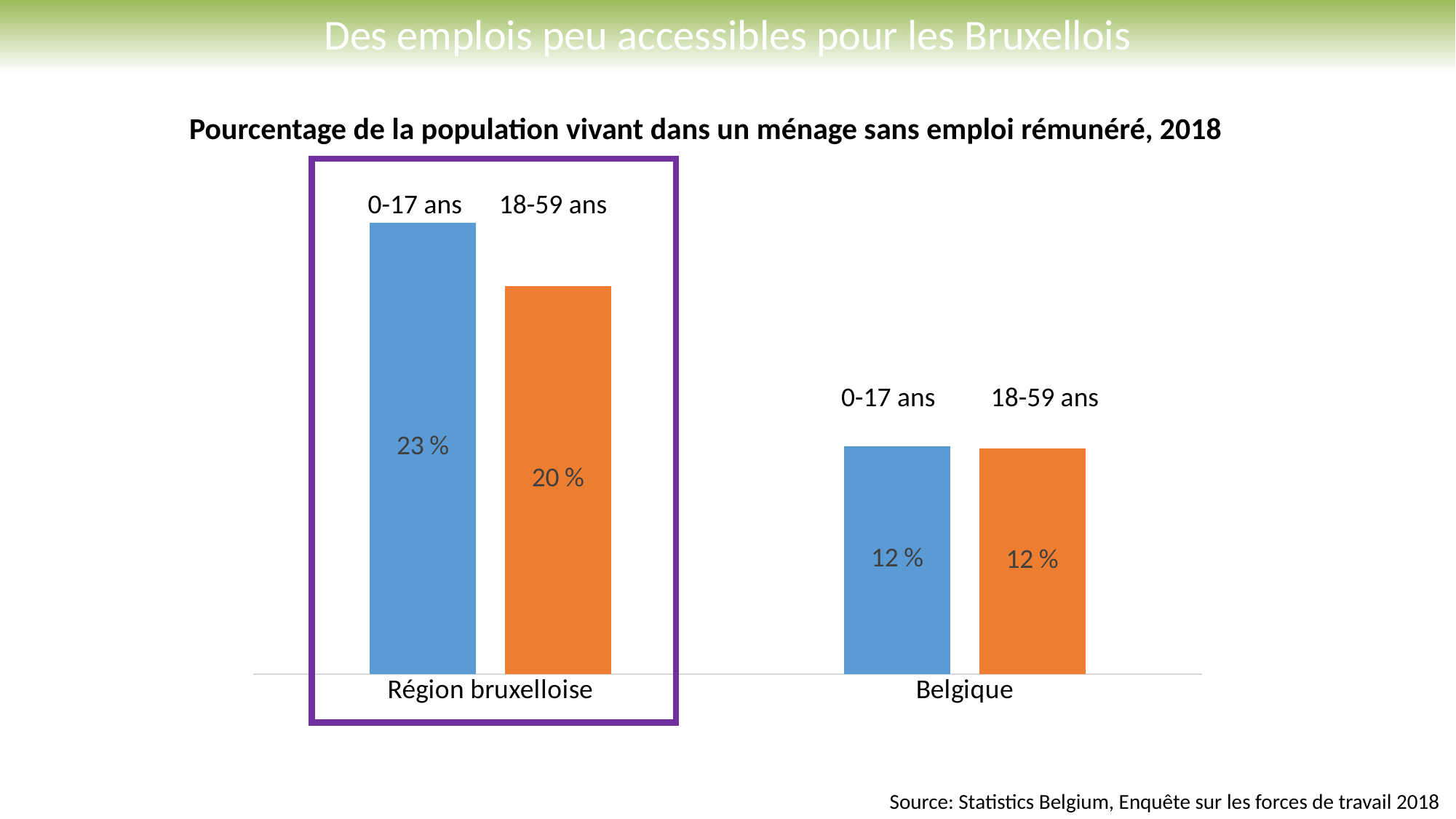
What is the difference between the 0-17 ans and 18-59 ans values for Région bruxelloise? 3 % What is the value for 0-17 ans in Région bruxelloise? 23 % How many age groups (series) are shown for each region? 2 What is the title of the chart? Pourcentage de la population vivant dans un ménage sans emploi rémunéré, 2018 Which bar has the highest value on the chart? 0-17 ans, Région bruxelloise What is the value for 0-17 ans in Belgique? 12 % What kind of chart is shown on the slide? Bar chart What is the difference between the 0-17 ans values for Région bruxelloise and Belgique? 11 % How many regions (categories) are shown on the x axis? 2 Which is larger: the 18-59 ans value for Région bruxelloise or for Belgique? Région bruxelloise What is the value for 18-59 ans in Belgique? 12 % What is the value for 18-59 ans in Région bruxelloise? 20 %